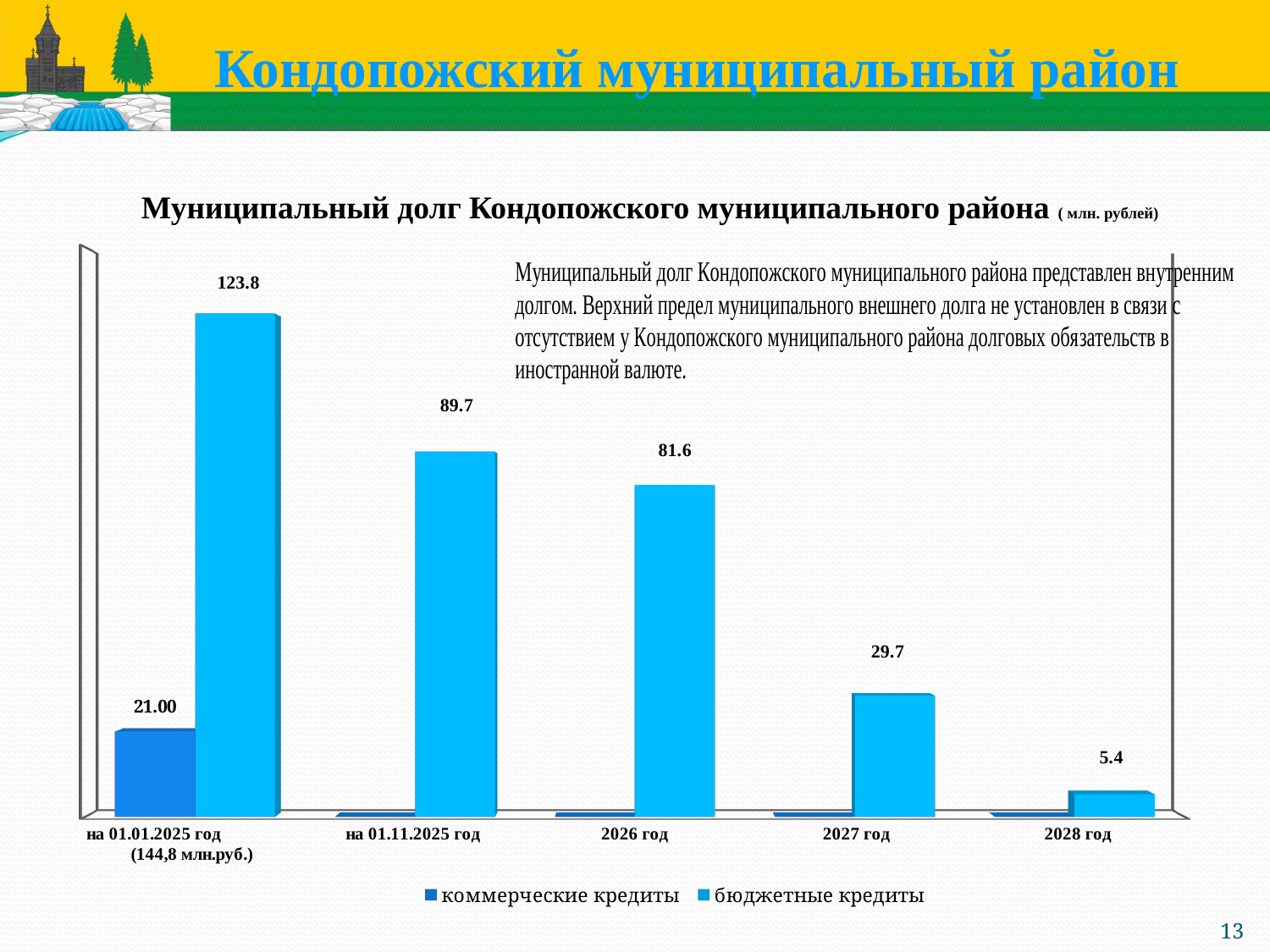
Which category has the highest value of бюджетные кредиты? на 01.01.2025 год Do the values of бюджетные кредиты rise or fall from left to right along the x axis? fall Which category has the lowest value of бюджетные кредиты? 2028 год What is the value of бюджетные кредиты for 2026 год? 81.6 What is the value of коммерческие кредиты for на 01.01.2025 год? 21.00 Which is larger: бюджетные кредиты for 2027 год or коммерческие кредиты for на 01.01.2025 год? бюджетные кредиты for 2027 год What is the value of бюджетные кредиты for 2028 год? 5.4 What kind of chart is shown on the slide? bar chart How many series does the legend list? 2 How many categories are shown on the x axis? 5 What is the difference between бюджетные кредиты for на 01.11.2025 год and 2026 год? 8.1 What is the value of бюджетные кредиты for на 01.01.2025 год? 123.8